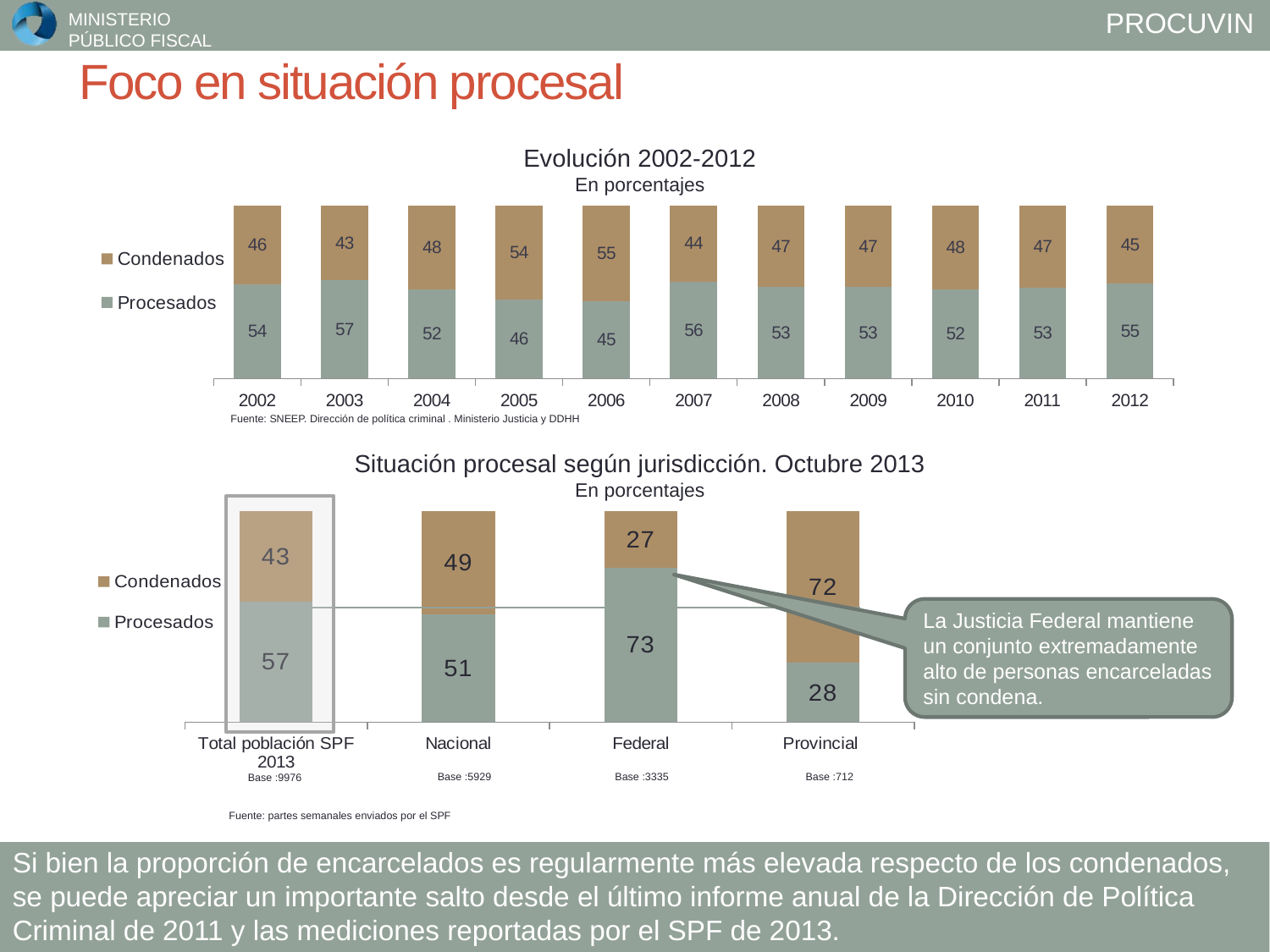
In the 'Situación procesal según jurisdicción. Octubre 2013' chart, what is the value for Procesados in Federal? 73 In the 'Situación procesal según jurisdicción. Octubre 2013' chart, what is the value for Condenados in Provincial? 72 In the 'Evolución 2002-2012' chart, which year has the lowest value for Procesados? 2006 In the 'Evolución 2002-2012' chart, what is the value for Condenados in 2006? 55 In the 'Evolución 2002-2012' chart, what is the difference between Procesados and Condenados in 2007? 12 In the 'Evolución 2002-2012' chart, which year has the highest value for Condenados? 2006 In the 'Evolución 2002-2012' chart, how many years are shown on the x axis? 11 In the 'Situación procesal según jurisdicción. Octubre 2013' chart, how many series does the legend list? 2 In the 'Situación procesal según jurisdicción. Octubre 2013' chart, is the value for Procesados larger in Nacional or in Federal? Federal In the 'Situación procesal según jurisdicción. Octubre 2013' chart, which jurisdiction has the lowest value for Condenados? Federal In the 'Evolución 2002-2012' chart, what is the value for Procesados in 2003? 57 What kind of chart is the 'Situación procesal según jurisdicción. Octubre 2013' chart? Stacked bar chart